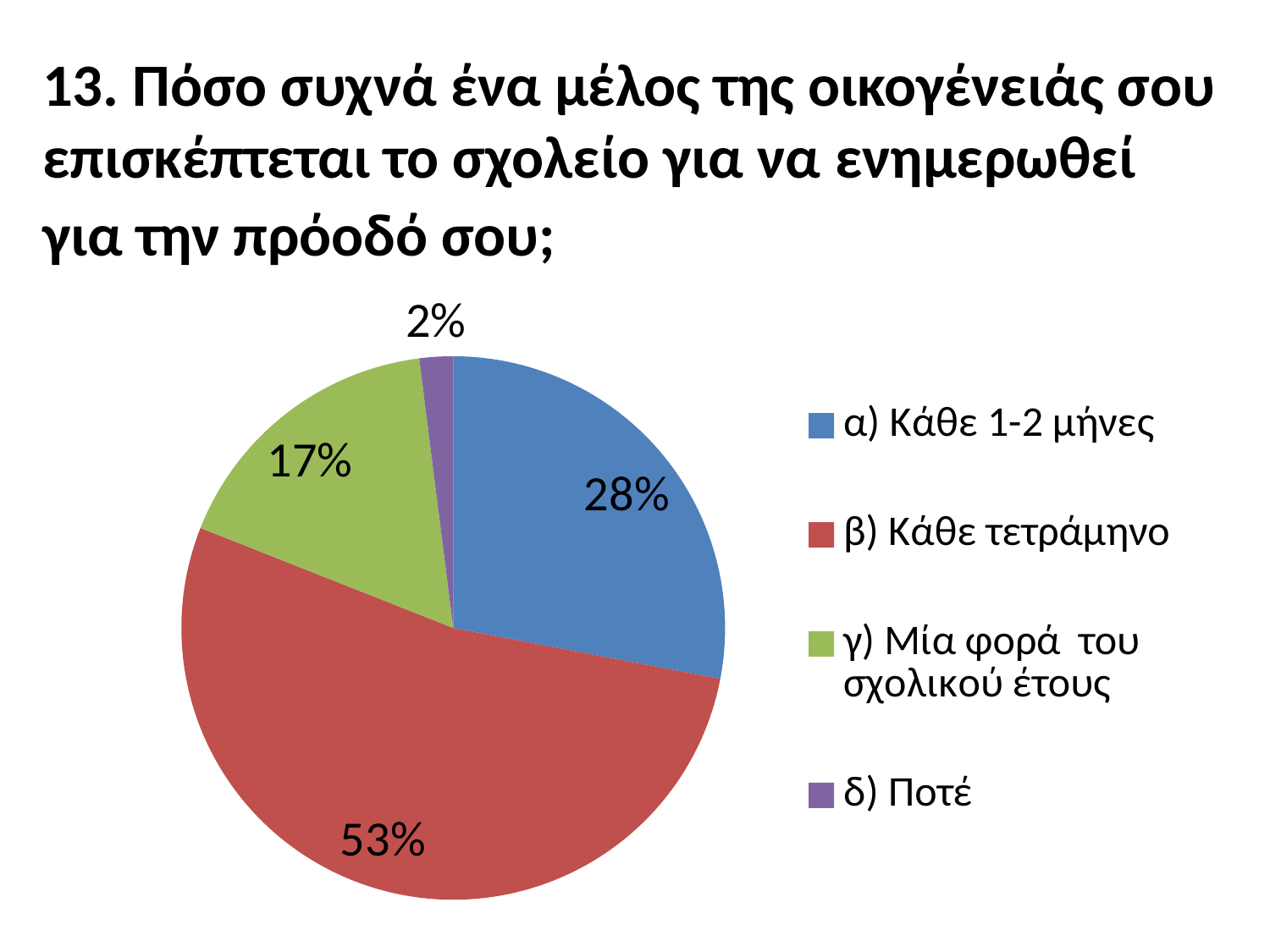
What percentage is shown for "γ) Μία φορά του σχολικού έτους"? 17% What is the difference in percentage points between "β) Κάθε τετράμηνο" and "α) Κάθε 1-2 μήνες"? 25 What colour is the slice for "β) Κάθε τετράμηνο"? red What colour is the slice for "γ) Μία φορά του σχολικού έτους"? green How many categories does the legend list? 4 What type of chart is shown on the slide? pie chart What percentage is shown for "δ) Ποτέ"? 2% What percentage is shown for "α) Κάθε 1-2 μήνες"? 28% Which category has the smallest slice of the pie? δ) Ποτέ Which category has the largest slice of the pie? β) Κάθε τετράμηνο What percentage is shown for "β) Κάθε τετράμηνο"? 53% Which is larger: the slice for "α) Κάθε 1-2 μήνες" or the slice for "γ) Μία φορά του σχολικού έτους"? α) Κάθε 1-2 μήνες